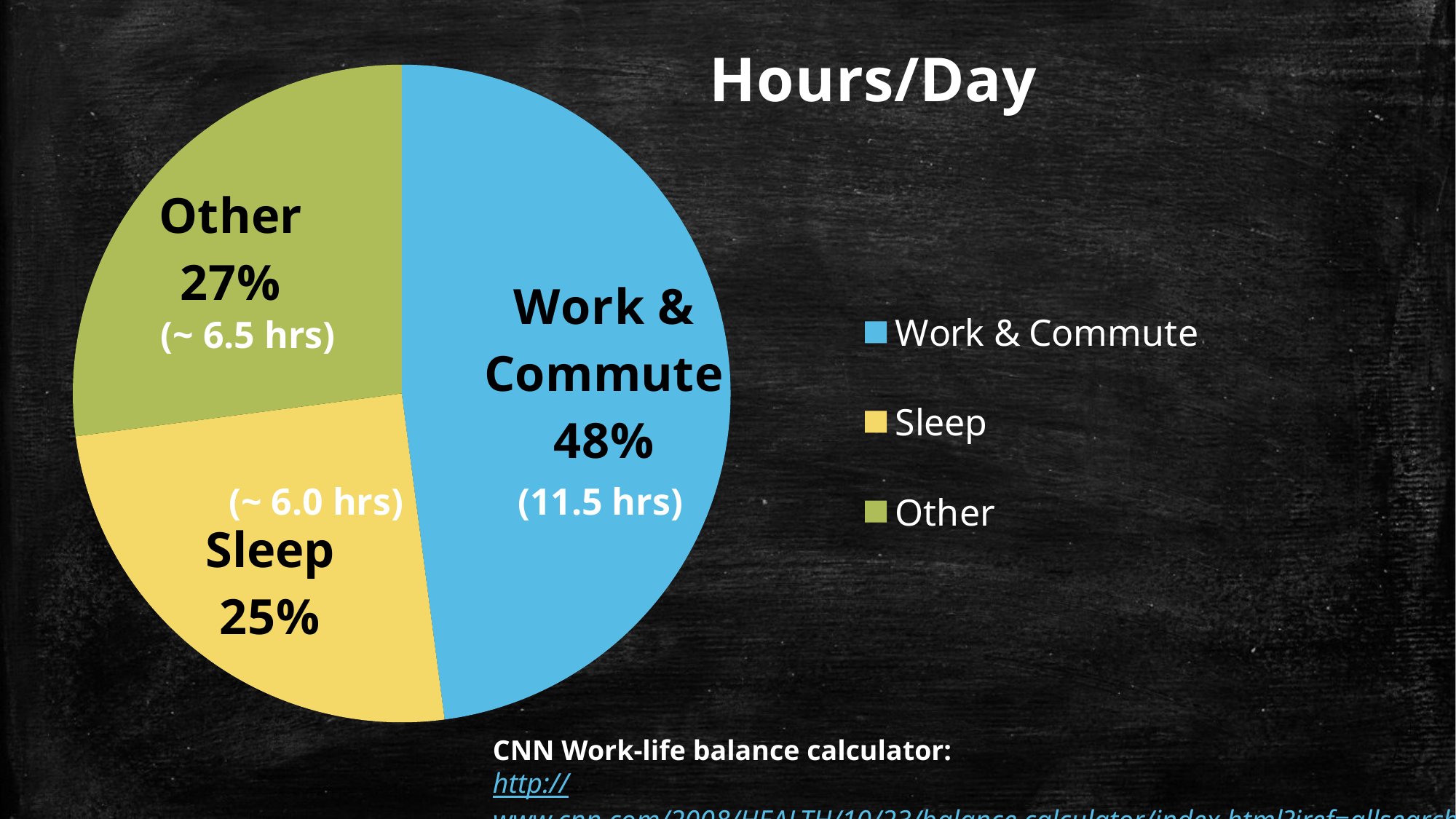
What colour is the Sleep slice? yellow Which category has the smallest slice of the pie? Sleep What percentage of the pie does Other take up? 27% What percentage of the pie does Work & Commute take up? 48% Which slice is larger, Other or Sleep? Other What is the difference in percentage points between the Work & Commute slice and the Sleep slice? 23 What kind of chart is shown on the slide? pie chart What is the title of the chart? Hours/Day How many categories does the pie chart have? 3 What percentage of the pie does Sleep take up? 25% How many hours per day are shown for Work & Commute? 11.5 hrs Which category has the largest slice of the pie? Work & Commute